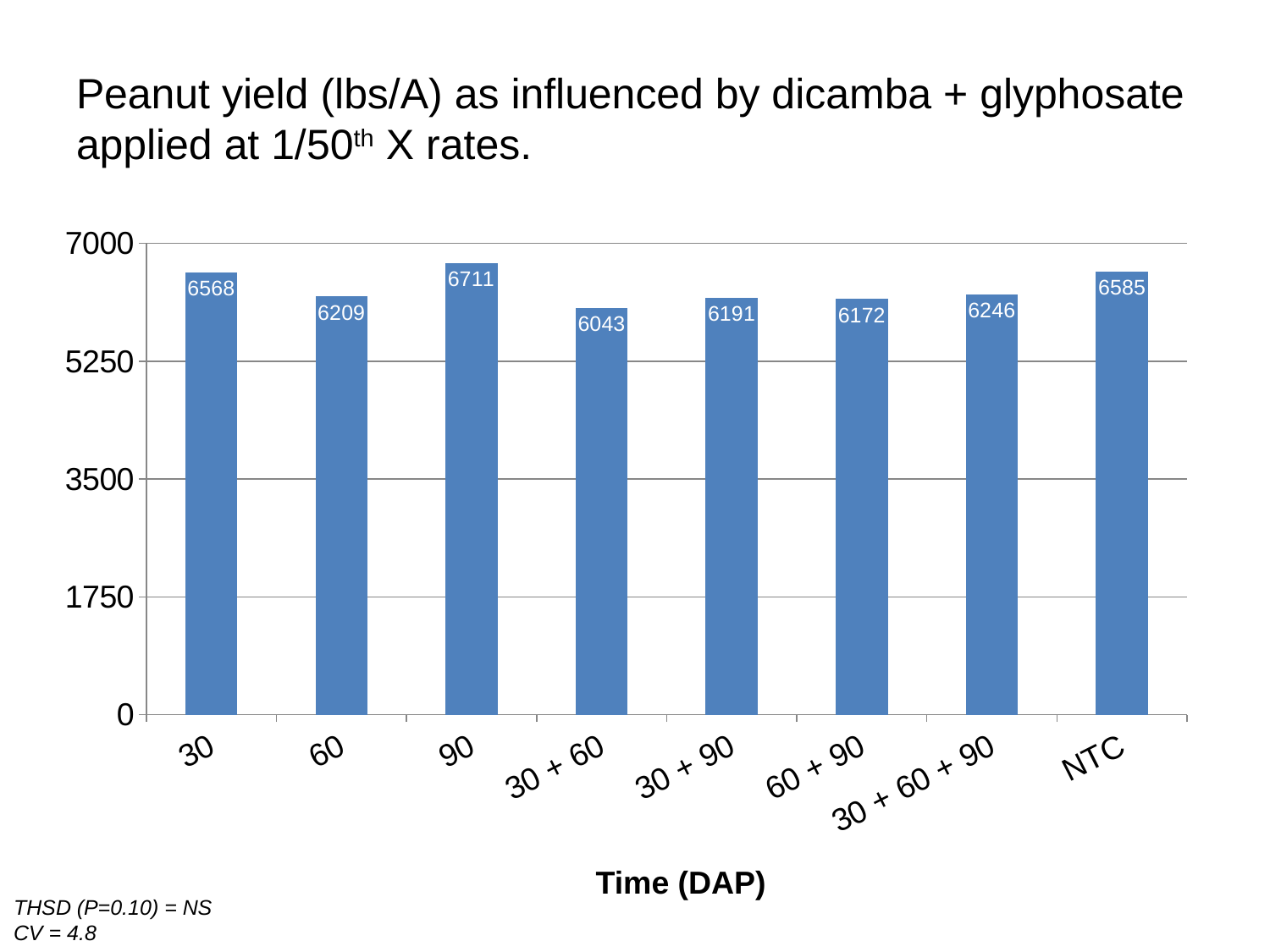
What is the peanut yield for the NTC treatment? 6585 What is the difference in yield between the NTC and the 60 DAP treatment? 376 Which treatment has the lowest peanut yield? 30 + 60 What is the peanut yield for the 30 DAP treatment? 6568 What is the x-axis title of the chart? Time (DAP) Which has a higher yield, the 30 DAP treatment or the 60 DAP treatment? 30 Is the yield for the 30 + 90 DAP treatment greater or less than 5250? greater What kind of chart is shown on the slide? bar chart What is the peanut yield for the 30 + 60 + 90 DAP treatment? 6246 How many treatments are shown on the x axis? 8 Which treatment has the highest peanut yield? 90 What is the difference in yield between the 90 DAP treatment and the 30 + 60 DAP treatment? 668